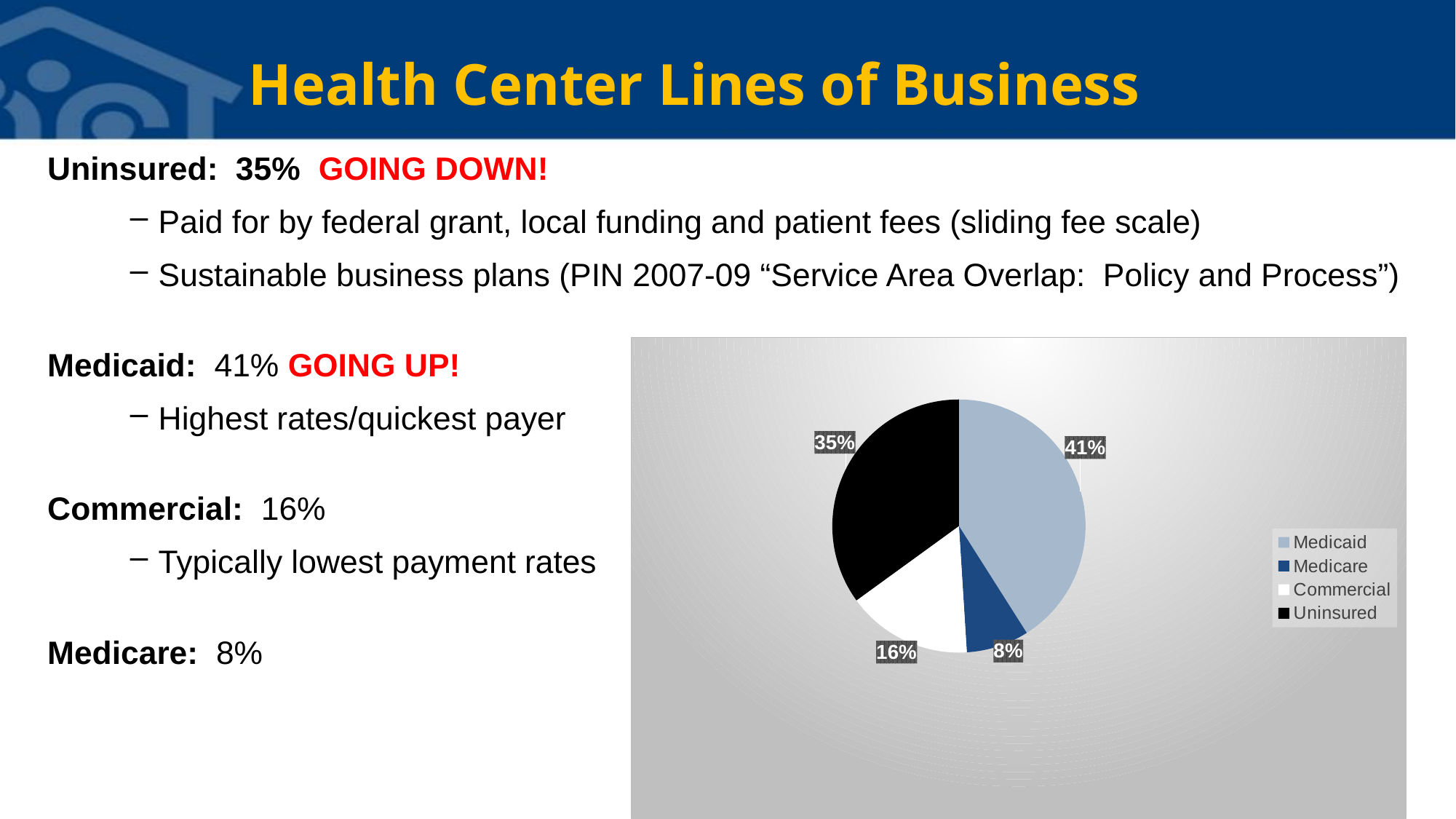
What kind of chart is shown on the slide? pie chart Which is larger, the Commercial slice or the Medicare slice? Commercial How many categories does the pie chart show? 4 What is the value shown for Commercial in the pie chart? 16% Which category is shown in black in the pie chart? Uninsured What is the value shown for Medicare in the pie chart? 8% Which category has the largest slice of the pie? Medicaid What is the difference between the Medicaid and Uninsured shares? 6% What share of the pie does Medicaid represent? 41% What share of the pie does Uninsured represent? 35% What is the difference between the Commercial and Medicare shares? 8% Which category has the smallest slice of the pie? Medicare